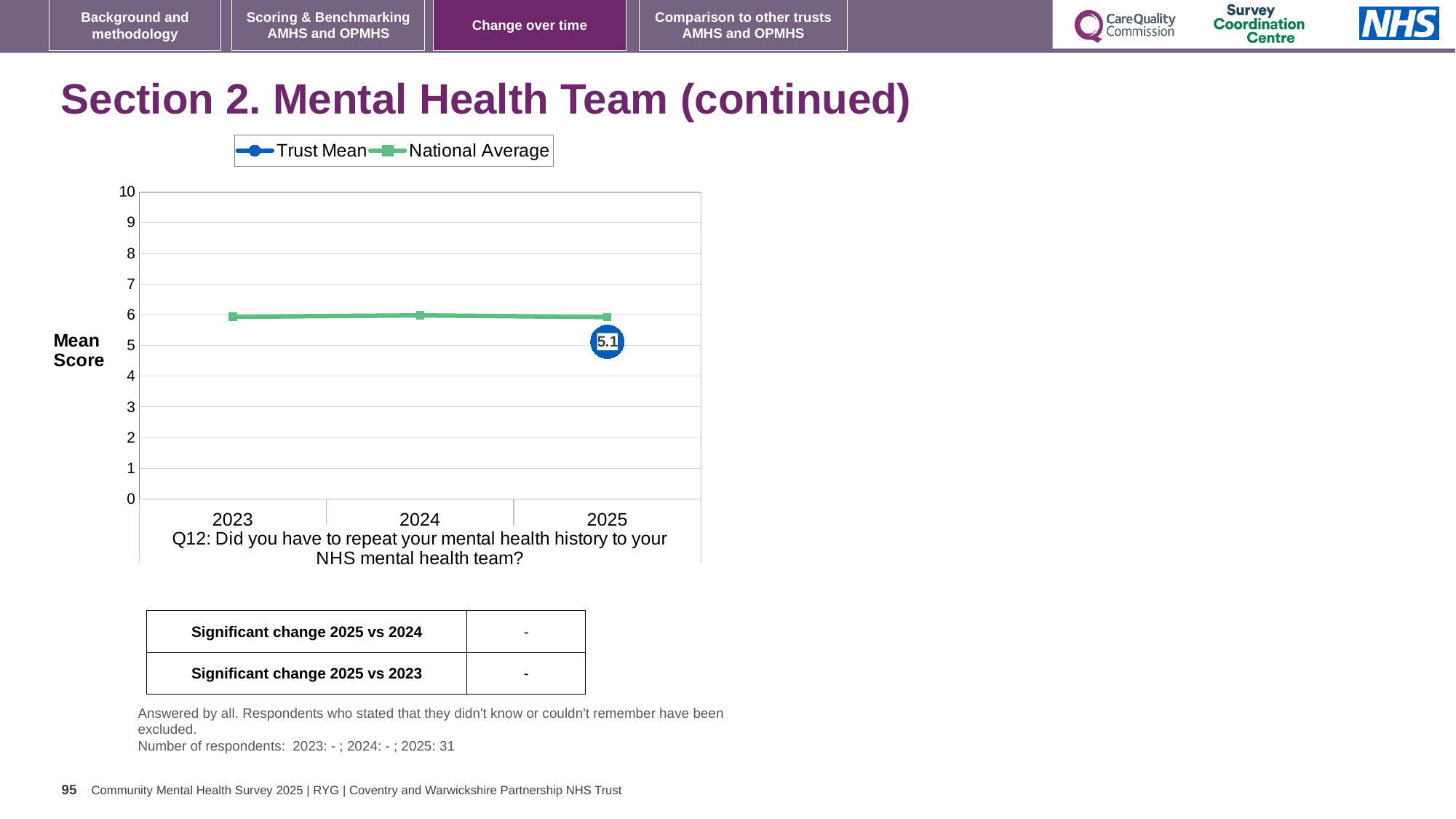
How many series does the legend list? 2 Is the National Average value for 2023 greater or less than 5? greater How many years are shown on the x axis? 3 Which series is shown in green? National Average What is the Trust Mean score for 2025? 5.1 Is the National Average value for 2024 greater or less than 7? less How many data points are plotted for the Trust Mean series? 1 In 2025, which is higher: the Trust Mean or the National Average? National Average What kind of chart is shown on the slide? line chart What is the label on the y axis? Mean Score Is the Trust Mean value for 2025 greater or less than 6? less